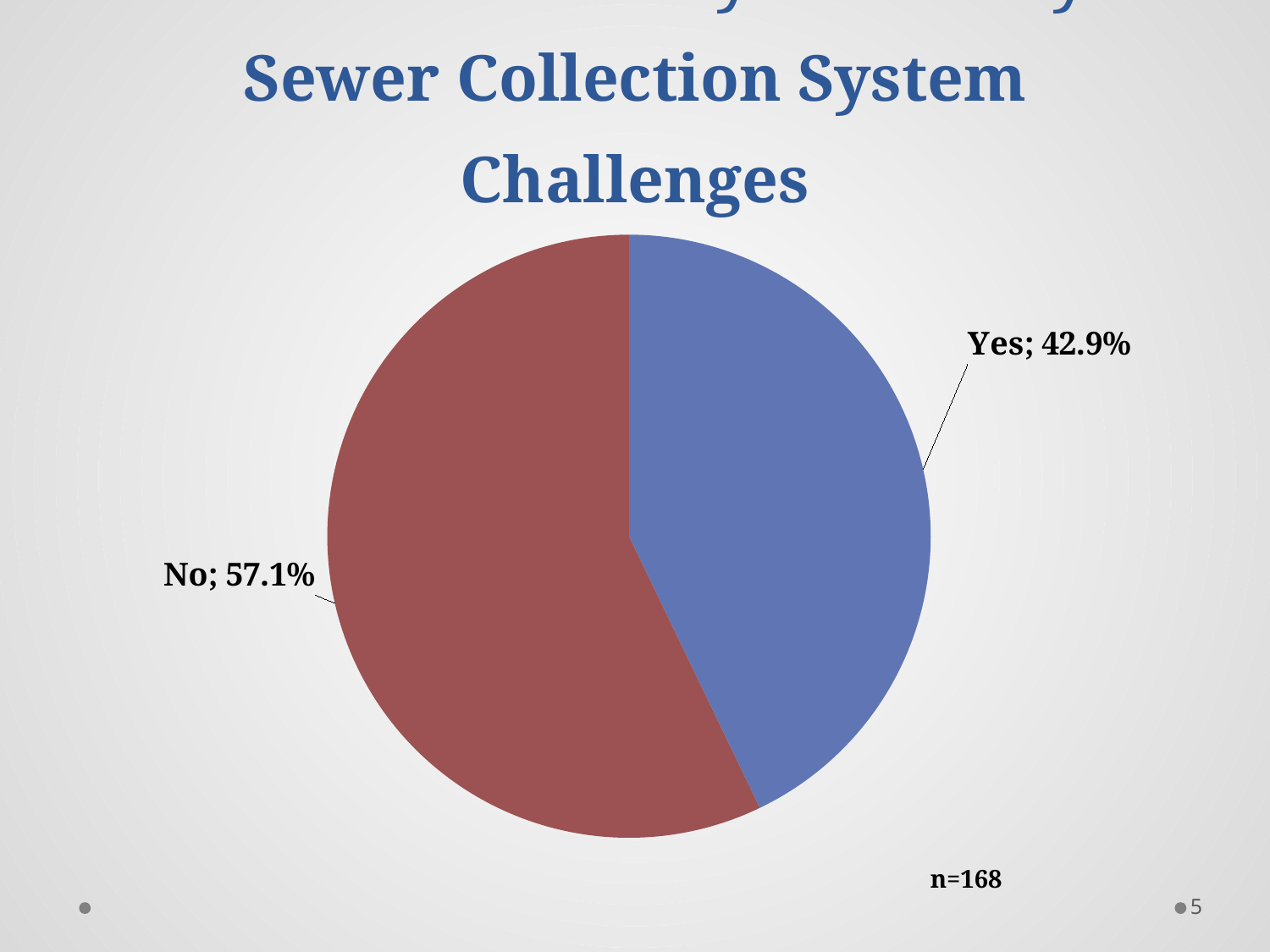
What is the sample size (n) shown on the slide? 168 What percentage of the pie is labelled "No"? 57.1% Which slice of the pie is the smallest? Yes Which is larger, the "Yes" slice or the "No" slice? No What is the difference in percentage points between the "No" slice and the "Yes" slice? 14.2 What kind of chart is shown on the slide? Pie chart What colour is the "Yes" slice of the pie? Blue What percentage of the pie is labelled "Yes"? 42.9% What share of the pie does the "No" slice represent? 57.1% How many slices does the pie chart have? 2 Which slice of the pie is the largest? No